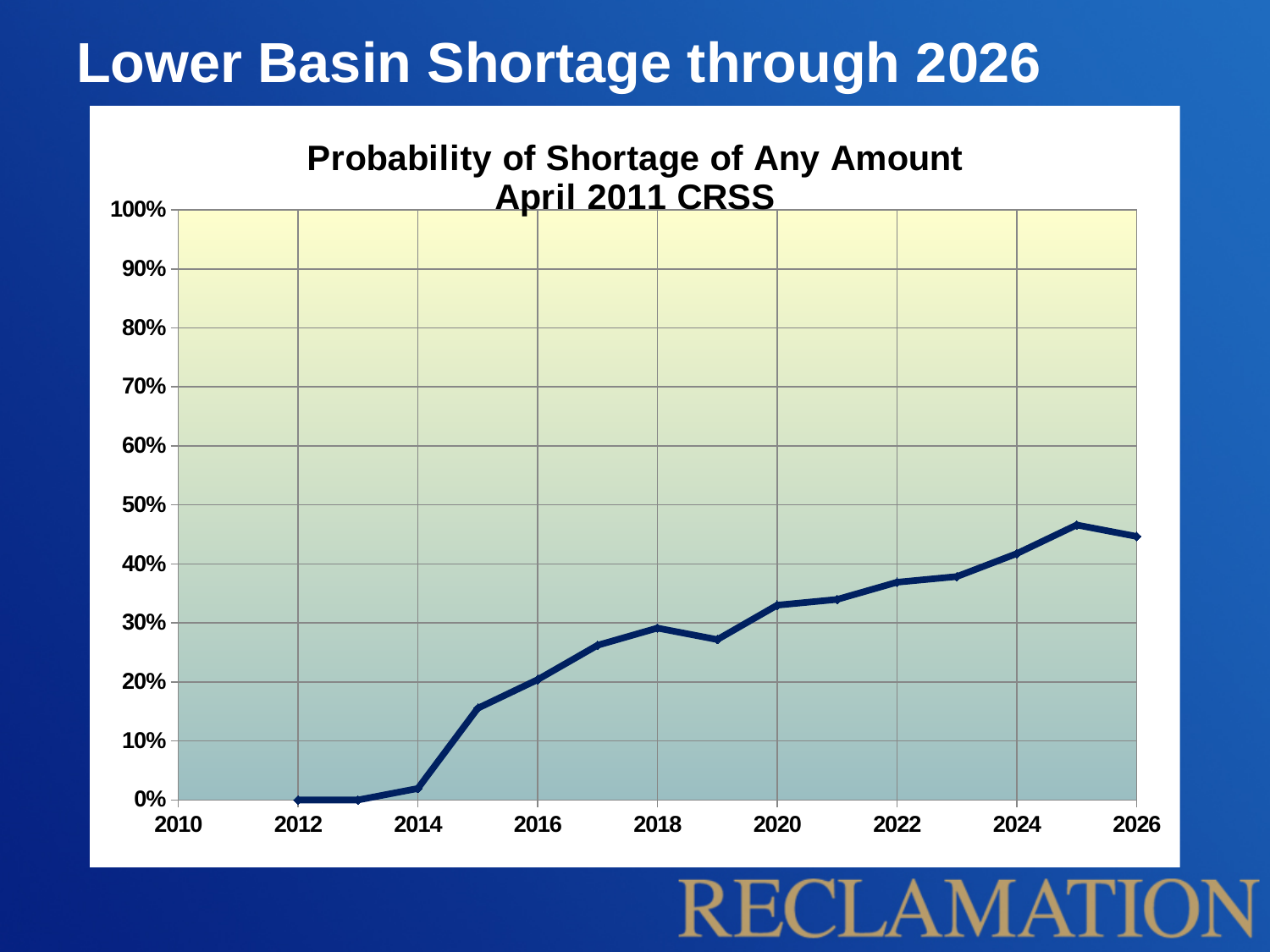
Which year has the highest probability of shortage? 2025 Is the value for 2020 greater or less than 30%? greater What kind of chart is shown on the slide? line chart What is the title of the chart? Probability of Shortage of Any Amount April 2011 CRSS Which is larger, the value for 2024 or the value for 2017? 2024 What is the probability of shortage plotted for 2012? 0% Is the value for 2015 greater or less than 20%? less Is the value for 2018 greater or less than 40%? less What is the probability of shortage plotted for 2013? 0% Which is larger, the value for 2019 or the value for 2018? 2018 Overall, does the probability of shortage rise or fall from 2012 to 2026? rise